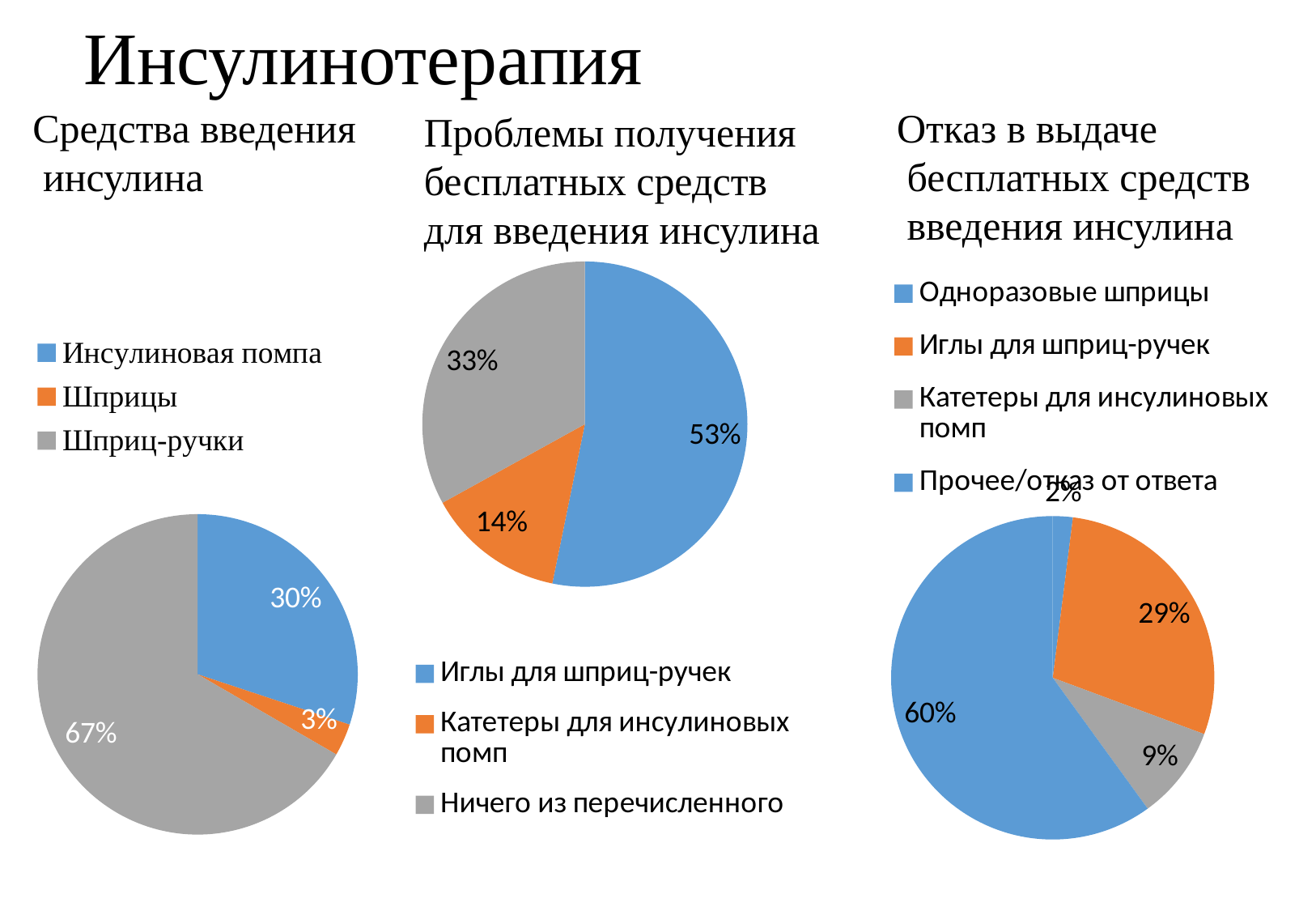
In the chart 'Отказ в выдаче бесплатных средств введения инсулина', what is the largest share shown? 60% In the chart 'Средства введения инсулина', what share is shown for Шприц-ручки? 67% In the chart 'Средства введения инсулина', which category has the smallest share? Шприцы In the chart 'Отказ в выдаче бесплатных средств введения инсулина', what share is shown for Иглы для шприц-ручек? 29% In the chart 'Средства введения инсулина', what share is shown for Инсулиновая помпа? 30% What type of chart is used for 'Средства введения инсулина'? Pie chart How many categories does the legend of the chart 'Отказ в выдаче бесплатных средств введения инсулина' list? 4 In the chart 'Проблемы получения бесплатных средств для введения инсулина', what share is shown for Катетеры для инсулиновых помп? 14% In the chart 'Проблемы получения бесплатных средств для введения инсулина', what share is shown for Иглы для шприц-ручек? 53% In the chart 'Отказ в выдаче бесплатных средств введения инсулина', what share is shown for Катетеры для инсулиновых помп? 9% In the chart 'Проблемы получения бесплатных средств для введения инсулина', which is larger: Ничего из перечисленного or Катетеры для инсулиновых помп? Ничего из перечисленного In the chart 'Средства введения инсулина', how many percentage points larger is Шприц-ручки than Инсулиновая помпа? 37